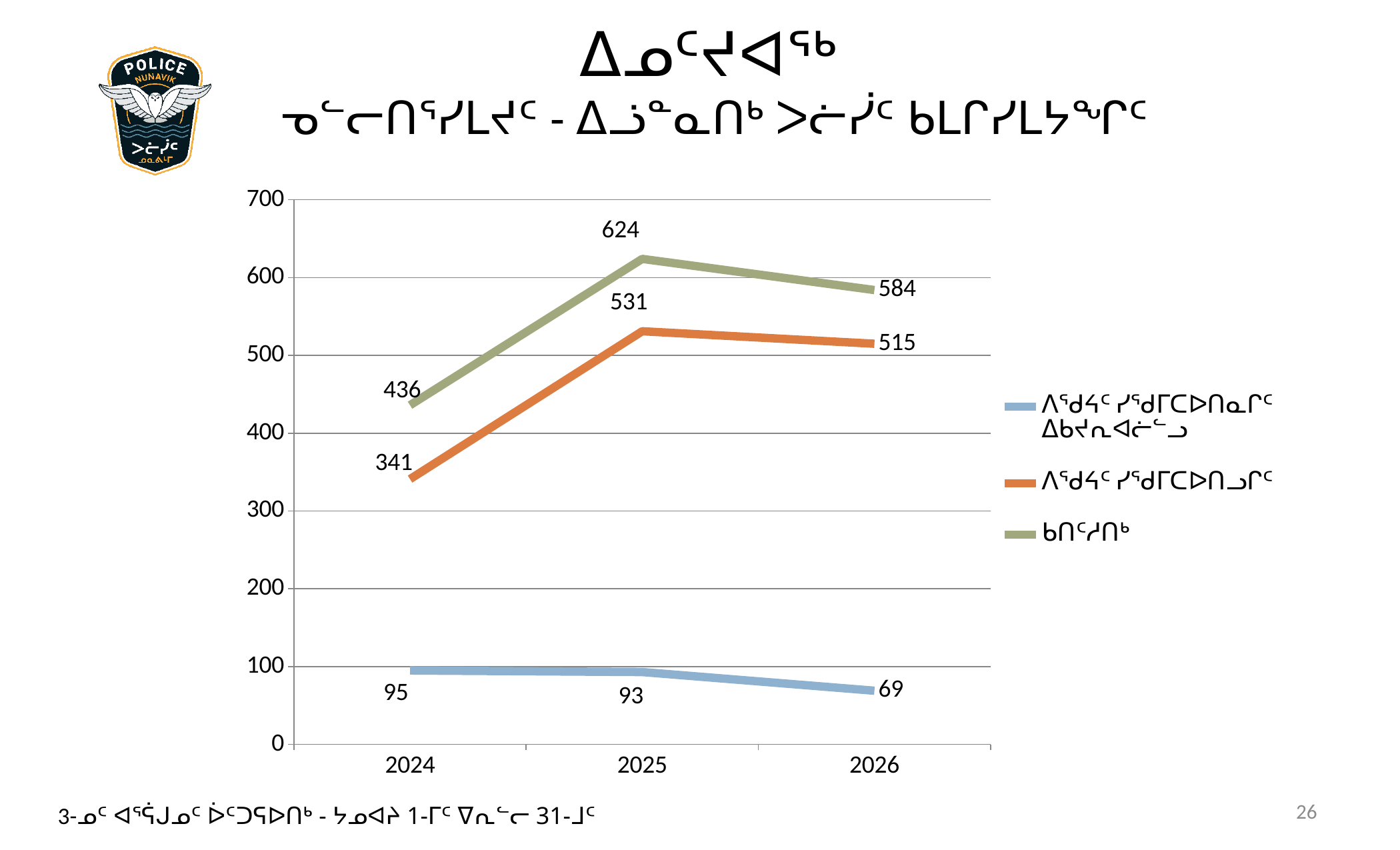
What is the difference between the green line's value in 2025 and its value in 2026? 40 Which is larger in 2026: the orange line's value or the green line's value? the green line (584) Does the orange line rise or fall from 2024 to 2025? rise What is the difference between the orange line's value in 2025 and its value in 2024? 190 What is the value of the orange line in 2024? 341 How many series does the legend list? 3 What kind of chart is shown on the slide? line chart In which year does the green line reach its highest value? 2025 What is the value of the green line in 2025? 624 What is the value of the blue line in 2026? 69 How many years are plotted along the x axis? 3 In which year is the blue line at its lowest value? 2026